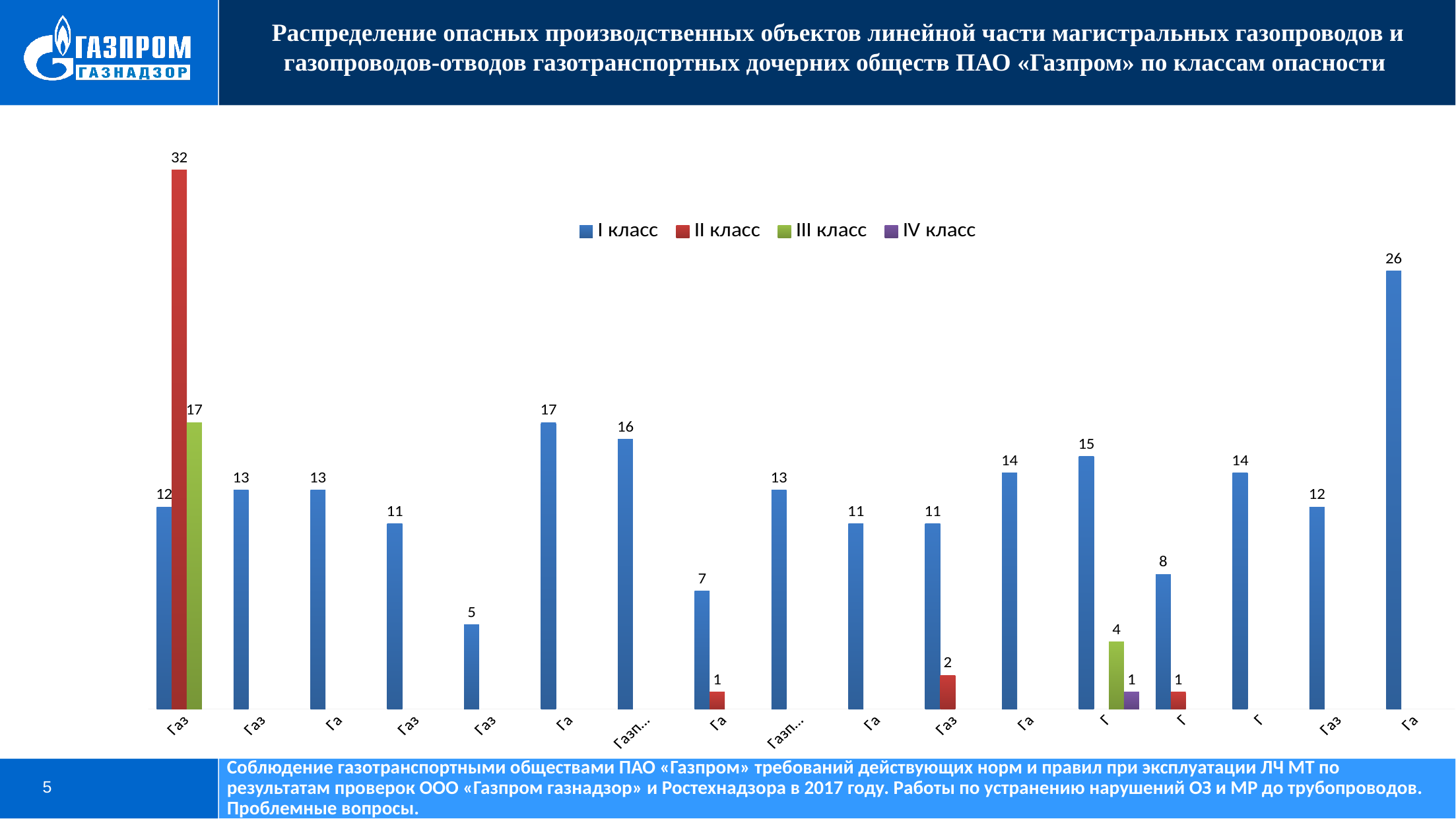
What is the total of the three bars in the first category from the left (12, 32 and 17)? 61 In the first category from the left, how much larger is the II класс value than the I класс value? 20 How many categories are plotted along the x axis? 17 What is the lowest value shown for the I класс series? 5 What is the highest value shown for the II класс series? 32 Which is larger: the I класс value in the last category on the right (26) or in the first category on the left (12)? the last category on the right What is the highest value shown for the I класс series? 26 What is the only value shown for the IV класс series? 1 How many series does the legend list? 4 What is the value of the III класс bar in the first category from the left? 17 What is the value of the I класс bar in the first category from the left? 12 What kind of chart is shown on the slide? bar chart